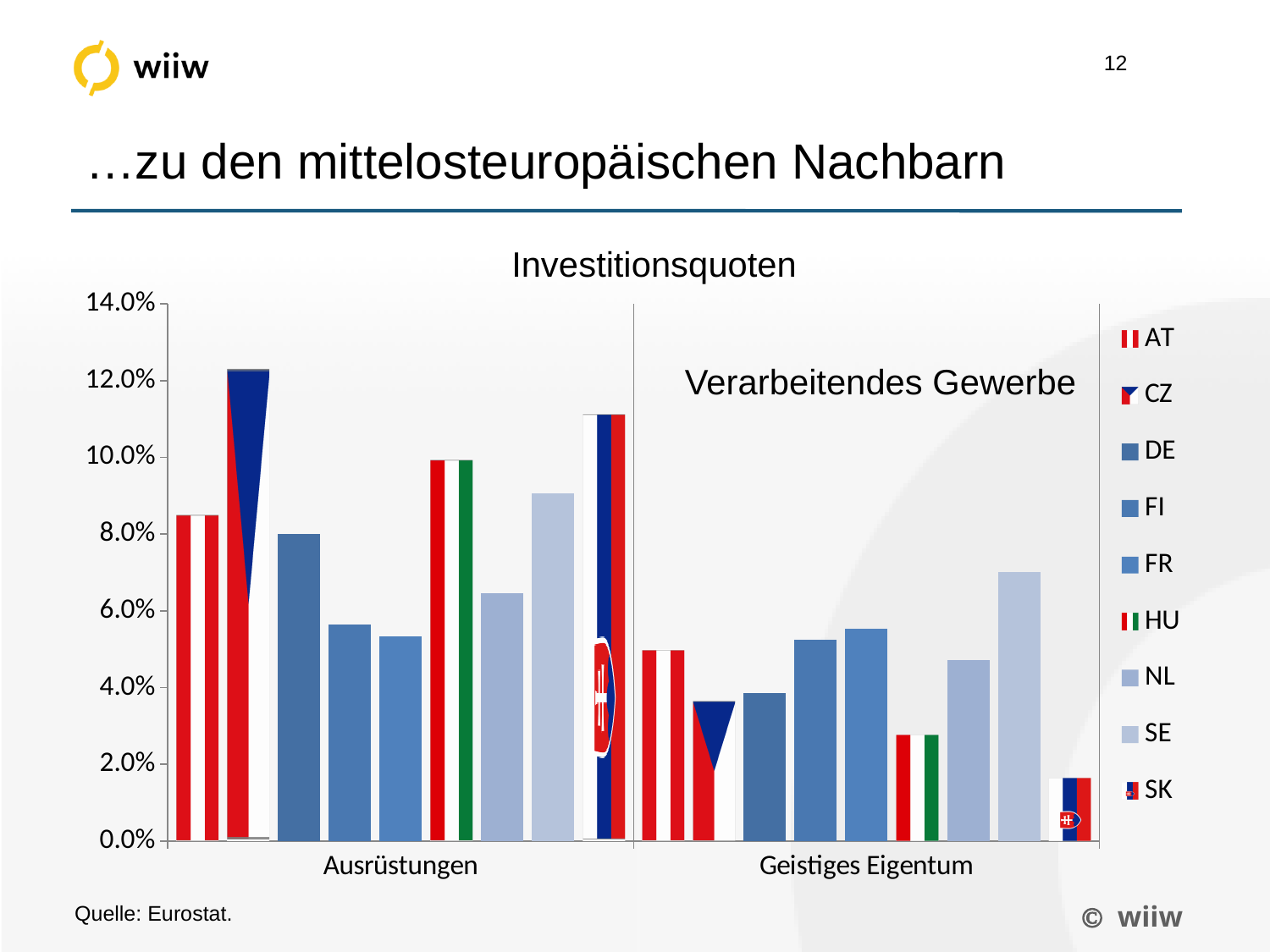
Which country has the lowest value in the Geistiges Eigentum category? SK Which country has the highest value in the Ausrüstungen category? CZ How many series does the legend list? 9 Which sector label is printed inside the plot area of the chart? Verarbeitendes Gewerbe Is the value for SK in Geistiges Eigentum greater or less than 2.0%? less What kind of chart is shown on the slide? bar chart How many categories are shown on the x axis? 2 Which country has the highest value in the Geistiges Eigentum category? SE In the Ausrüstungen category, which is larger: the value for SK or the value for DE? SK Is the value for CZ in Ausrüstungen greater or less than 12.0%? greater What is the title of the chart? Investitionsquoten